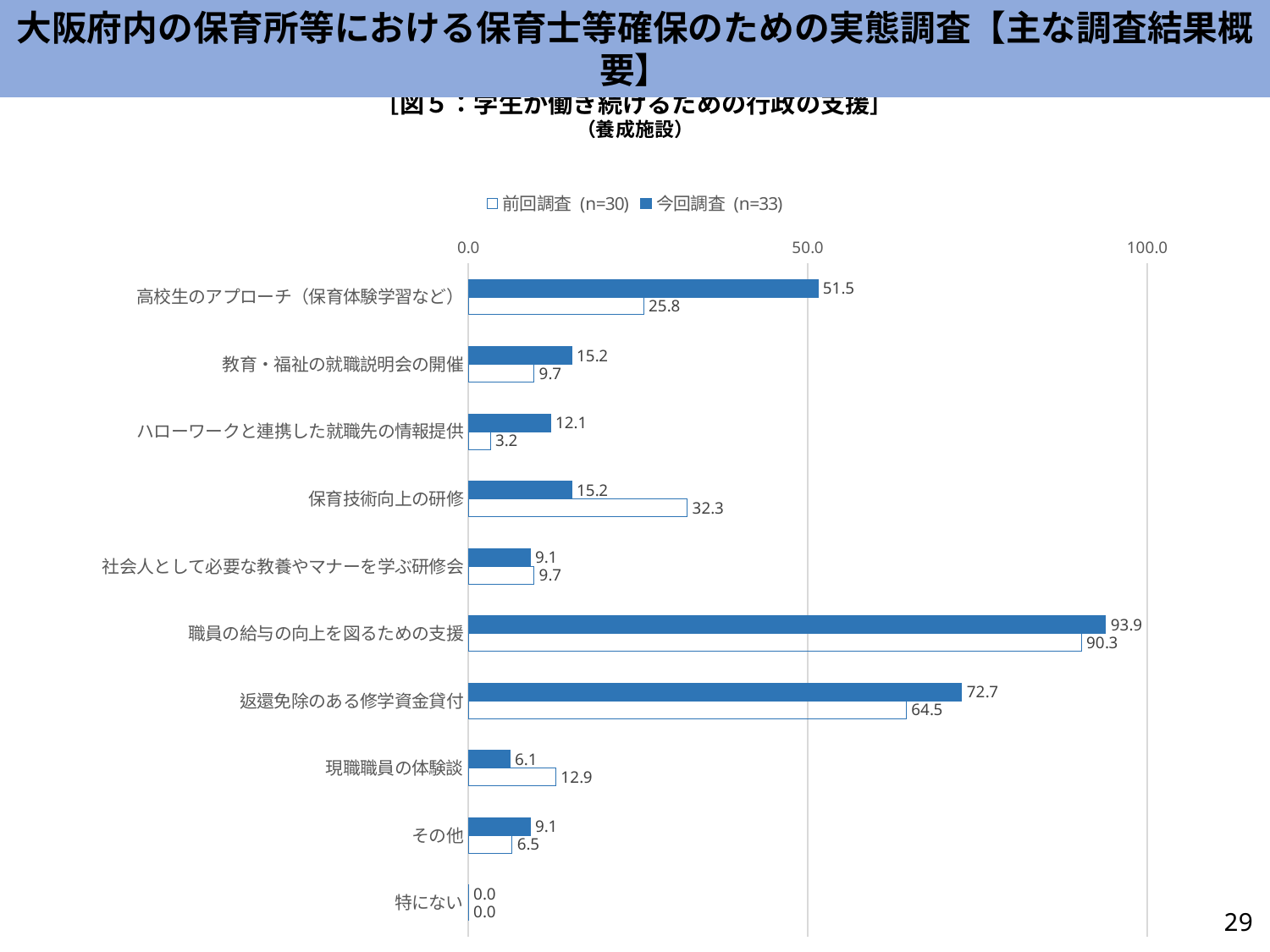
How many series does the legend list? 2 Is the 今回調査 (n=33) value for 高校生のアプローチ（保育体験学習など） greater or less than 50.0? greater For 現職職員の体験談, which is larger: the 前回調査 (n=30) value or the 今回調査 (n=33) value? 前回調査 (n=30) What is the value for 今回調査 (n=33) for 職員の給与の向上を図るための支援? 93.9 What is the value for 今回調査 (n=33) for ハローワークと連携した就職先の情報提供? 12.1 Which category has the lowest value for 前回調査 (n=30)? 特にない What is the value for 前回調査 (n=30) for 高校生のアプローチ（保育体験学習など）? 25.8 What is the value for 前回調査 (n=30) for 保育技術向上の研修? 32.3 What is the difference between the 今回調査 (n=33) and 前回調査 (n=30) values for 返還免除のある修学資金貸付? 8.2 How many categories are shown on the chart? 10 What kind of chart is shown on the slide? bar chart Which category has the highest value for 今回調査 (n=33)? 職員の給与の向上を図るための支援